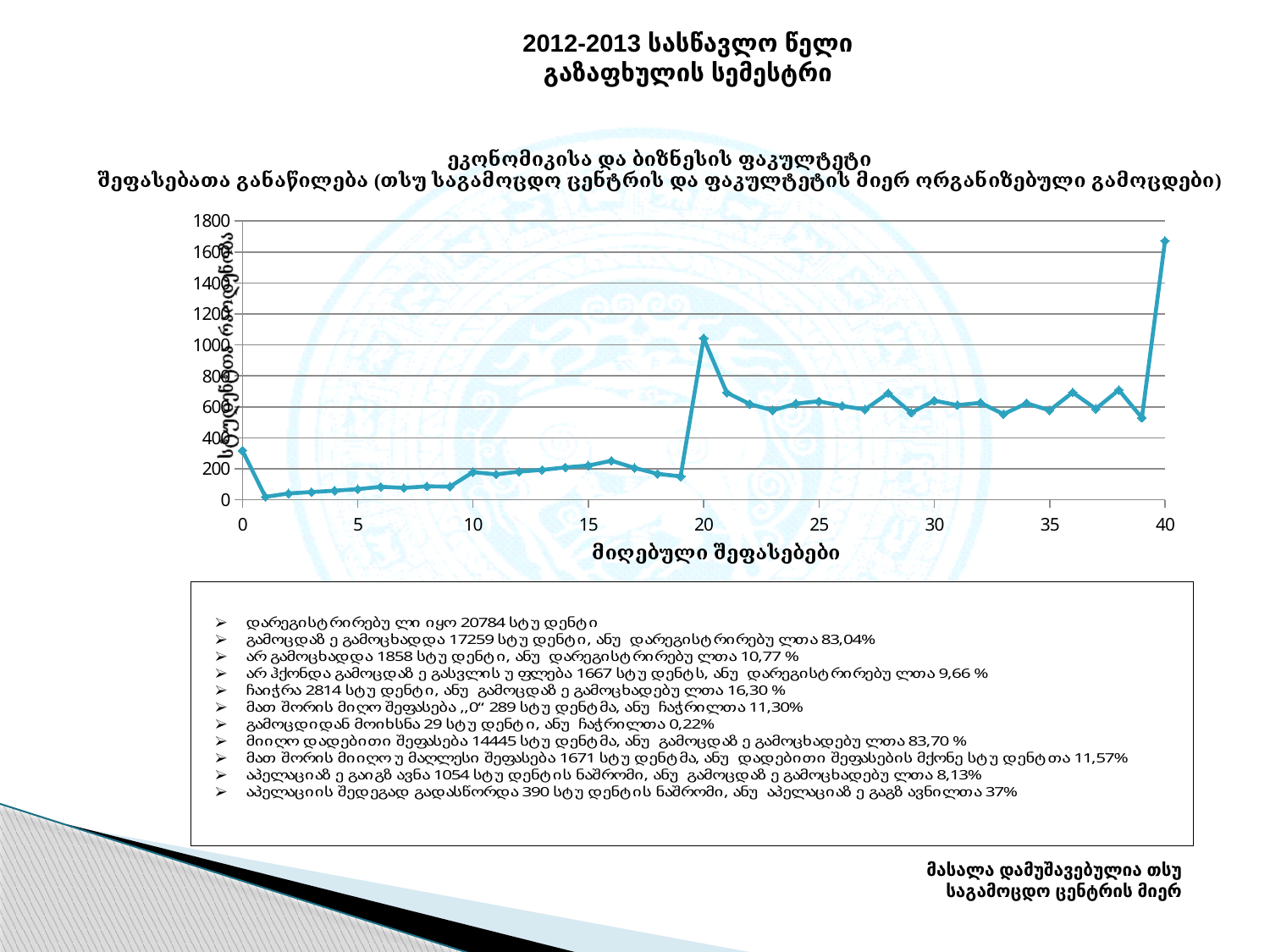
Is the value at score 0 greater or less than 400? less Is the value at score 40 greater or less than 1600? greater Which has the larger value, score 0 or score 1? score 0 At which score on the x axis does the line reach its lowest value? 1 What kind of chart is shown on the slide? line chart Which has the larger value, score 20 or score 21? score 20 What is the label of the x axis? მიღებული შეფასებები Is the value at score 20 greater or less than 800? greater At which score on the x axis does the line reach its highest value? 40 Do the values generally rise or fall between score 1 and score 16? rise